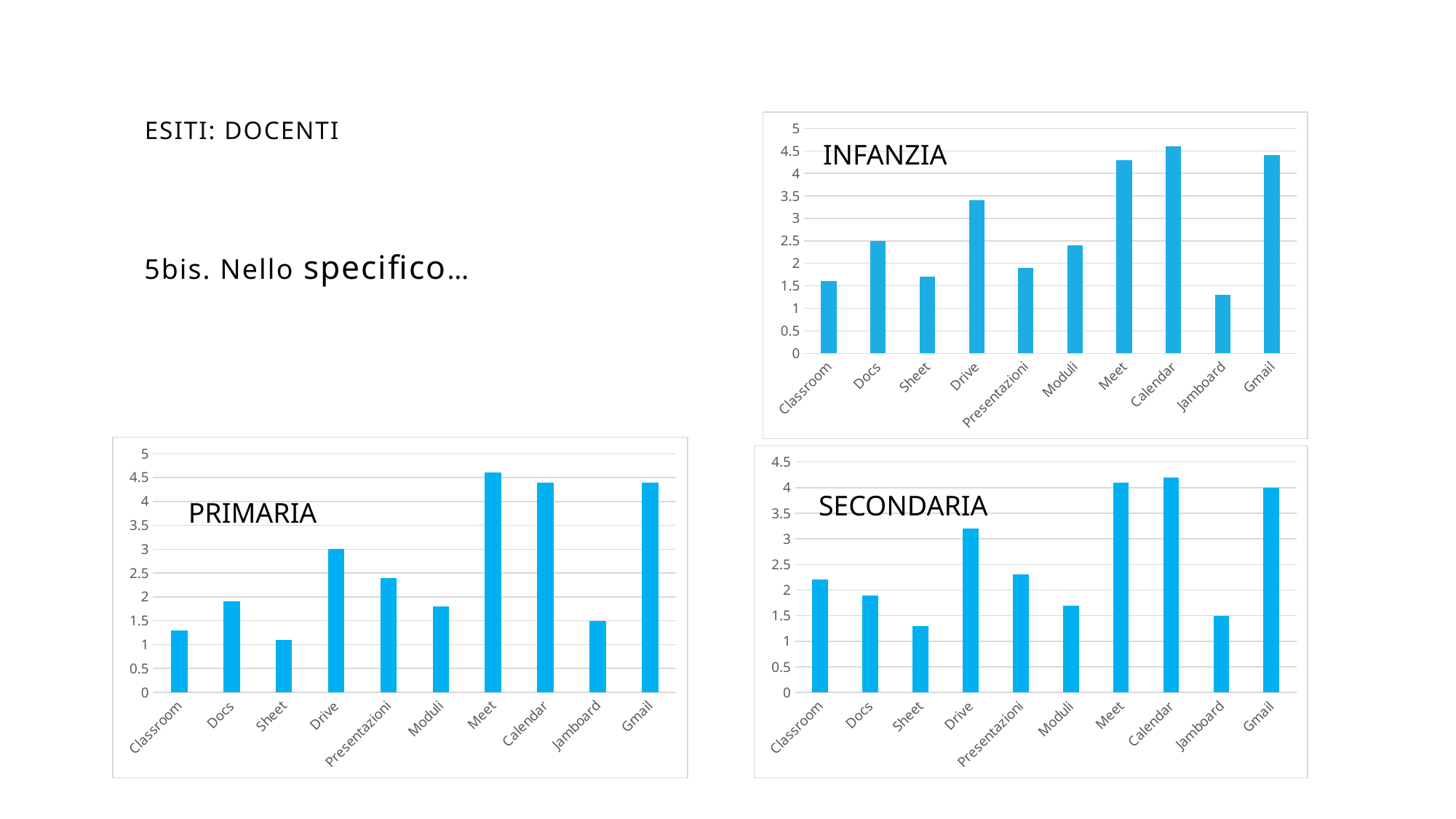
What kind of chart is the INFANZIA chart? bar chart In the INFANZIA chart, which category has the highest value? Calendar In the PRIMARIA chart, which category has the highest value? Meet What is the title shown inside the chart at the bottom right of the slide? SECONDARIA In the INFANZIA chart, which category has the lowest value? Jamboard In the INFANZIA chart, is the value for Drive greater or less than 3? greater How many categories are shown on the x axis of the PRIMARIA chart? 10 In the SECONDARIA chart, which is larger, the value for Drive or the value for Sheet? Drive In the INFANZIA chart, which is larger, the value for Meet or the value for Moduli? Meet In the PRIMARIA chart, which category has the lowest value? Sheet In the PRIMARIA chart, is the value for Jamboard greater or less than 2? less